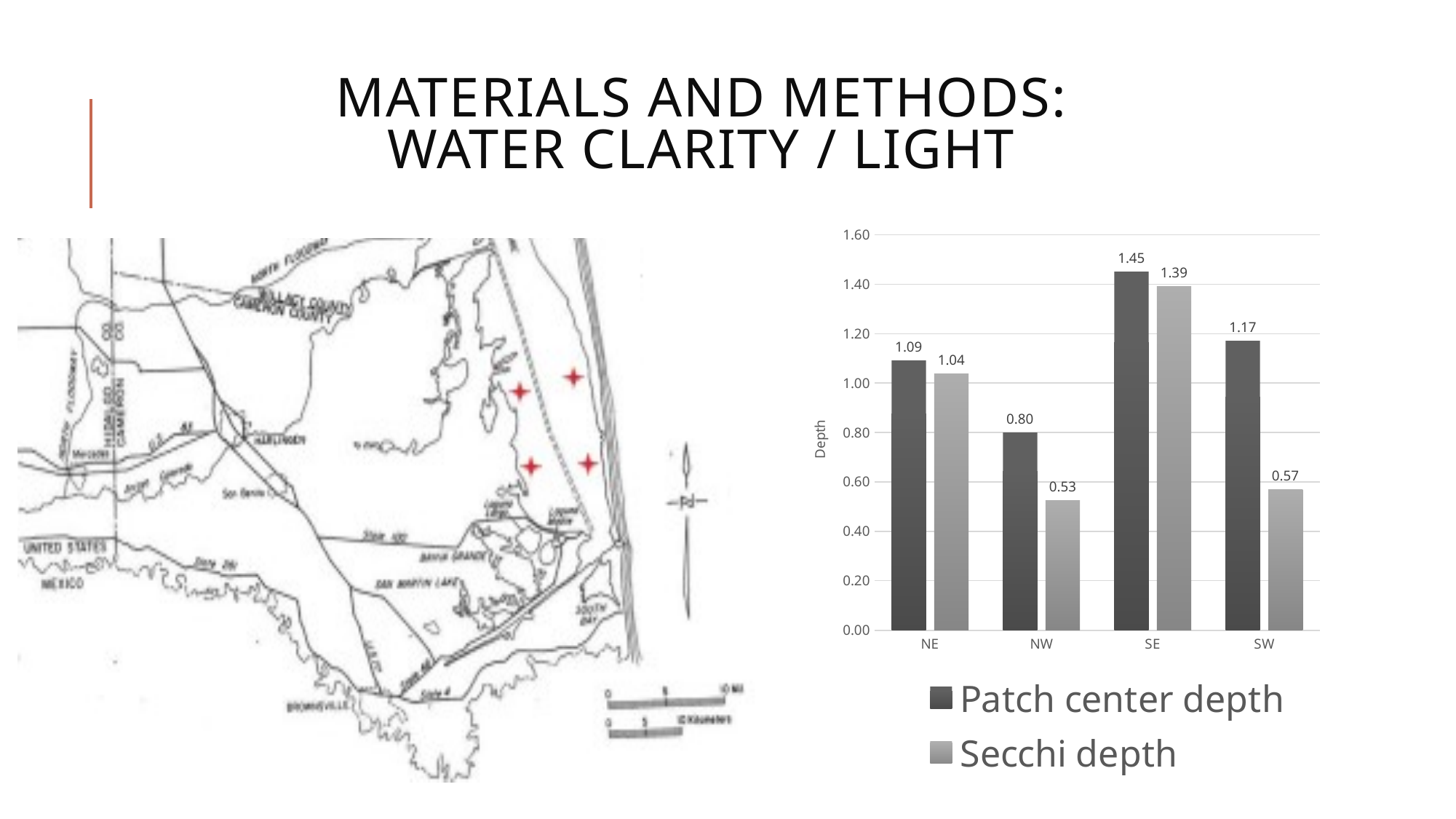
What is the Secchi depth for SW? 0.57 Which category has the highest Patch center depth? SE What kind of chart is shown on the slide? Bar chart How many series does the chart's legend list? 2 How many categories are shown on the x axis of the chart? 4 What is the Secchi depth for NW? 0.53 What is the Patch center depth for SE? 1.45 Which is larger, the Patch center depth for NE or the Patch center depth for SW? Patch center depth for SW What is the label of the y axis of the chart? Depth What is the difference between the Patch center depth and the Secchi depth for NW? 0.27 Which category has the lowest Secchi depth? NW Is the Secchi depth for SE greater or less than 1.20? greater